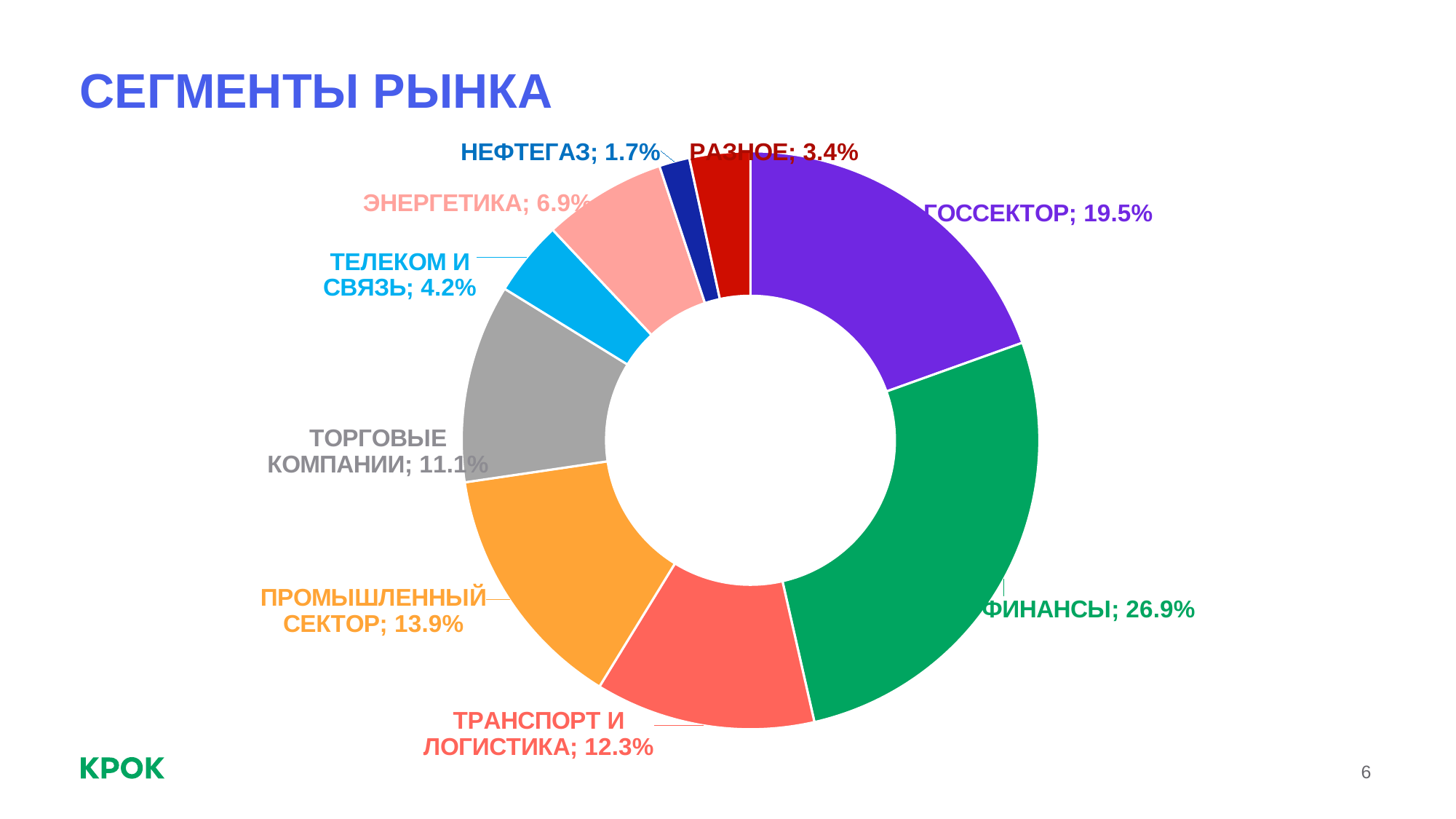
What is the difference between the shares of ФИНАНСЫ and ГОССЕКТОР? 7.4% Which segment has the smallest share? НЕФТЕГАЗ What is the title of the chart? СЕГМЕНТЫ РЫНКА What kind of chart is shown on the slide? Pie chart (donut) Which is larger, ПРОМЫШЛЕННЫЙ СЕКТОР or ТОРГОВЫЕ КОМПАНИИ? ПРОМЫШЛЕННЫЙ СЕКТОР How many segments does the chart have? 9 What colour is the ЭНЕРГЕТИКА segment? Light pink What share does ТЕЛЕКОМ И СВЯЗЬ have? 4.2% What share does ТРАНСПОРТ И ЛОГИСТИКА have? 12.3% Which segment has the largest share? ФИНАНСЫ What share does ФИНАНСЫ have? 26.9% What share does ГОССЕКТОР have? 19.5%